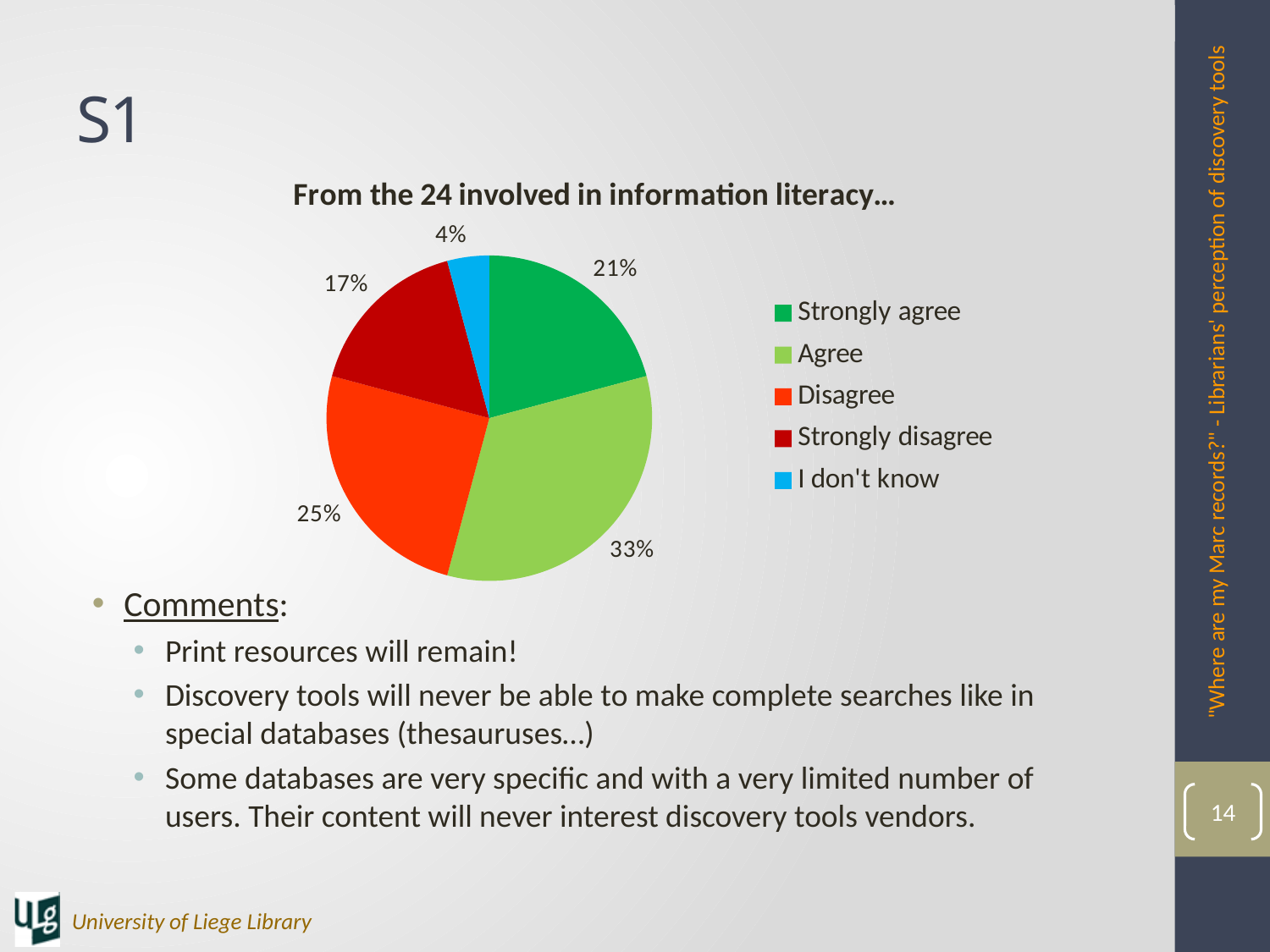
What is the difference in percentage points between the "Agree" and "Strongly disagree" slices? 16 What share of the pie is labelled "Strongly disagree"? 17% Which slice is larger, "Disagree" or "Strongly agree"? Disagree What is the title of the chart? From the 24 involved in information literacy… What share of the pie is labelled "I don't know"? 4% Which category has the smallest slice of the pie? I don't know What share of the pie is labelled "Agree"? 33% What kind of chart is shown on the slide? pie chart Which category has the largest slice of the pie? Agree How many categories does the legend list? 5